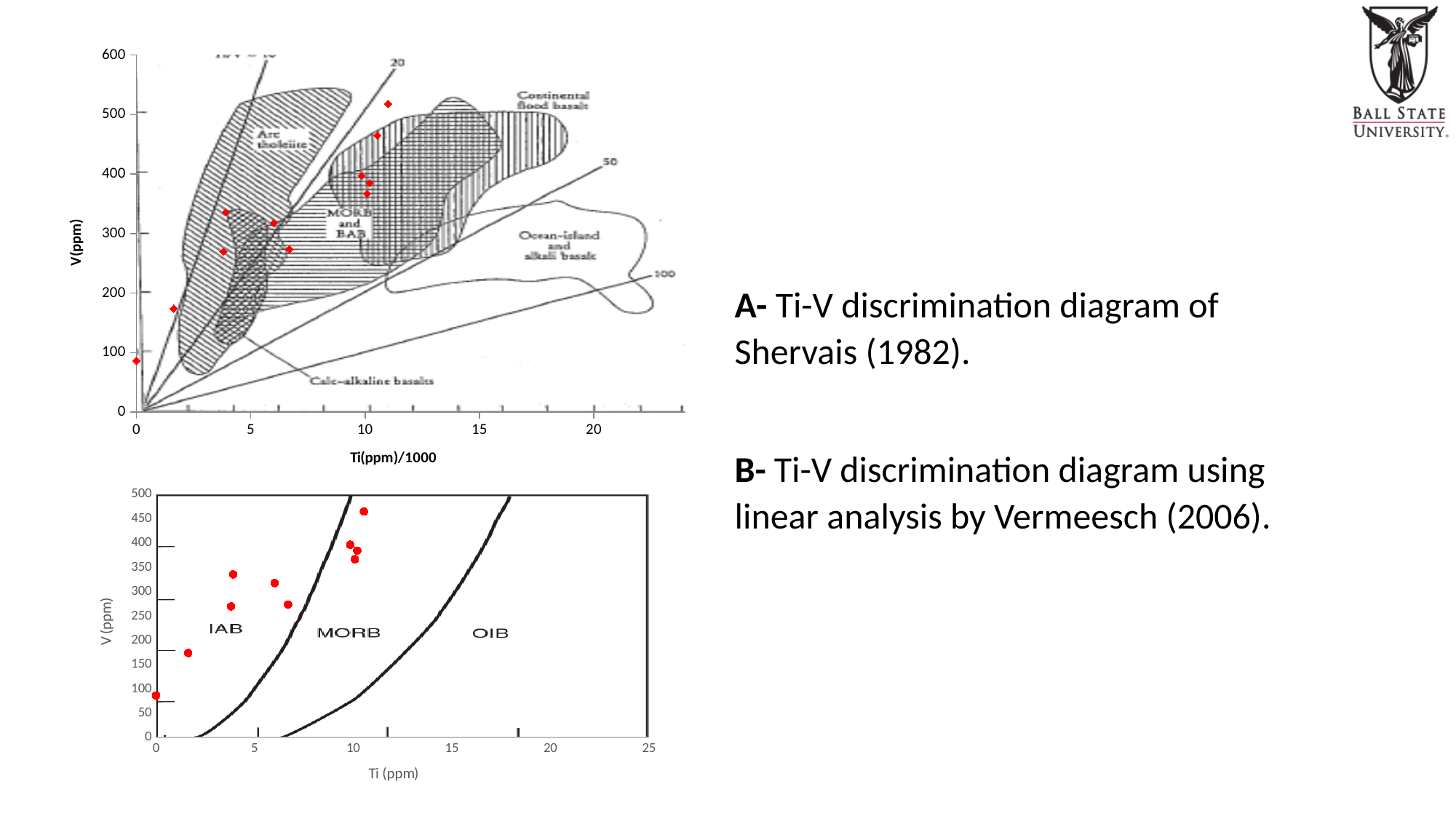
What are the three field labels shown in chart B (Vermeesch 2006)? IAB, MORB, OIB In chart B (Vermeesch 2006), which of the two points at Ti of about 10 has the larger V value: the one near 465 or the one near 370? the one near 465 In chart B (Vermeesch 2006), is the V value of the highest plotted point greater or less than 450? greater In chart A (Shervais 1982), is the V value of the highest plotted point greater or less than 500? greater What kind of chart is chart B, the Ti-V discrimination diagram using linear analysis by Vermeesch (2006)? scatter chart What is the label of the x axis of chart B (Vermeesch 2006)? Ti (ppm) In chart A (Shervais 1982), is the V value of the lowest plotted point greater or less than 100? less In chart B (Vermeesch 2006), do the V values of the plotted points generally rise or fall as Ti increases? rise In chart A (Shervais 1982), do the V values of the plotted points generally rise or fall as Ti increases? rise What kind of chart is chart A, the Ti-V discrimination diagram of Shervais (1982)? scatter chart